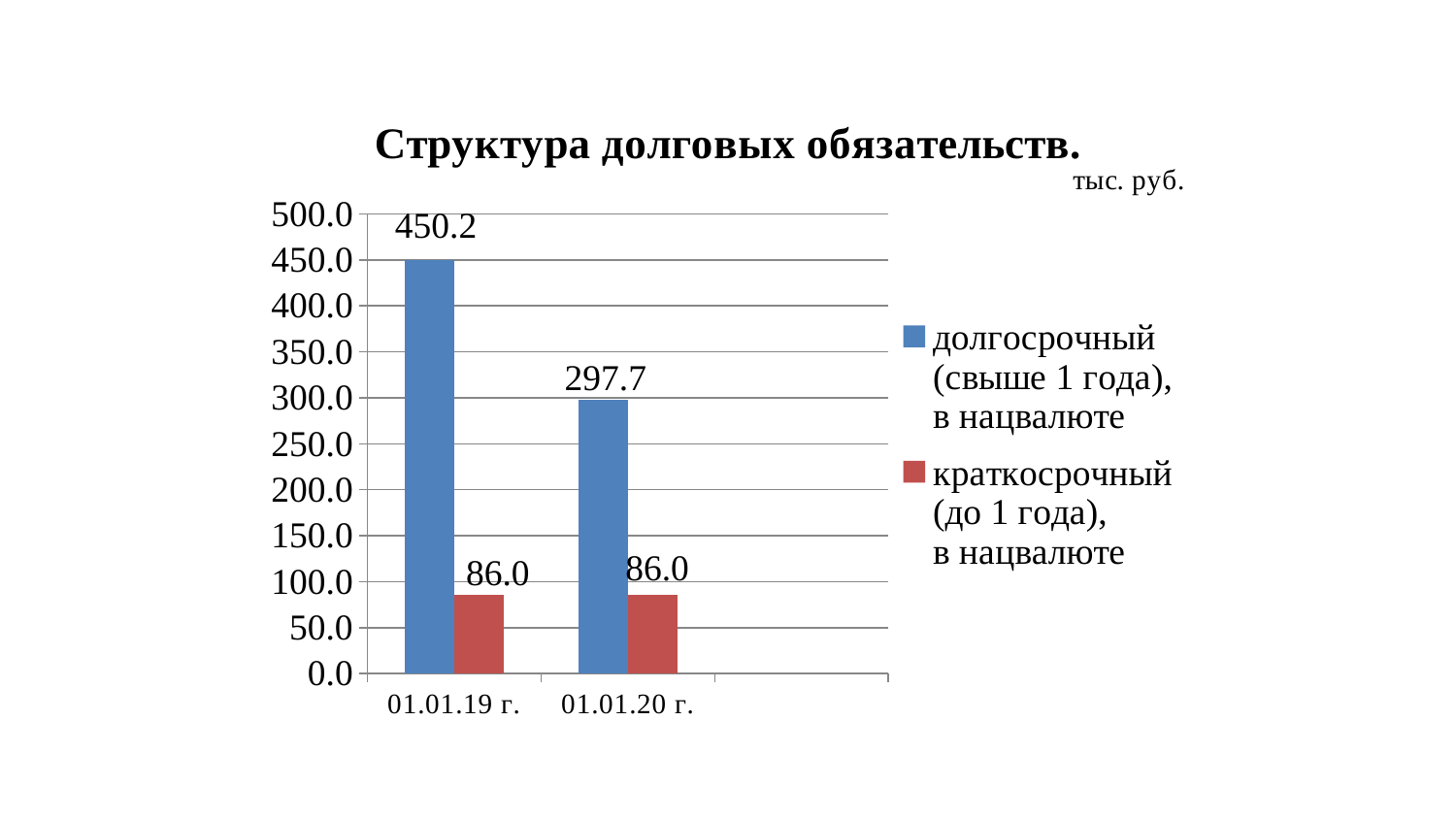
What is the value of the long-term (долгосрочный) series for 01.01.19 г.? 450.2 What is the value of the long-term (долгосрочный) series for 01.01.20 г.? 297.7 Which is larger for 01.01.19 г.: the long-term or the short-term value? long-term (долгосрочный) What type of chart is shown on the slide? bar chart How many series does the legend list? 2 What is the difference between the long-term values for 01.01.19 г. and 01.01.20 г.? 152.5 Which date has the highest long-term (долгосрочный) value? 01.01.19 г. What is the difference between the long-term and short-term values for 01.01.20 г.? 211.7 How many dates (categories) are shown on the x axis? 2 What is the value of the short-term (краткосрочный) series for 01.01.19 г.? 86.0 What is the value of the short-term (краткосрочный) series for 01.01.20 г.? 86.0 Does the long-term (долгосрочный) value rise or fall from 01.01.19 г. to 01.01.20 г.? fall